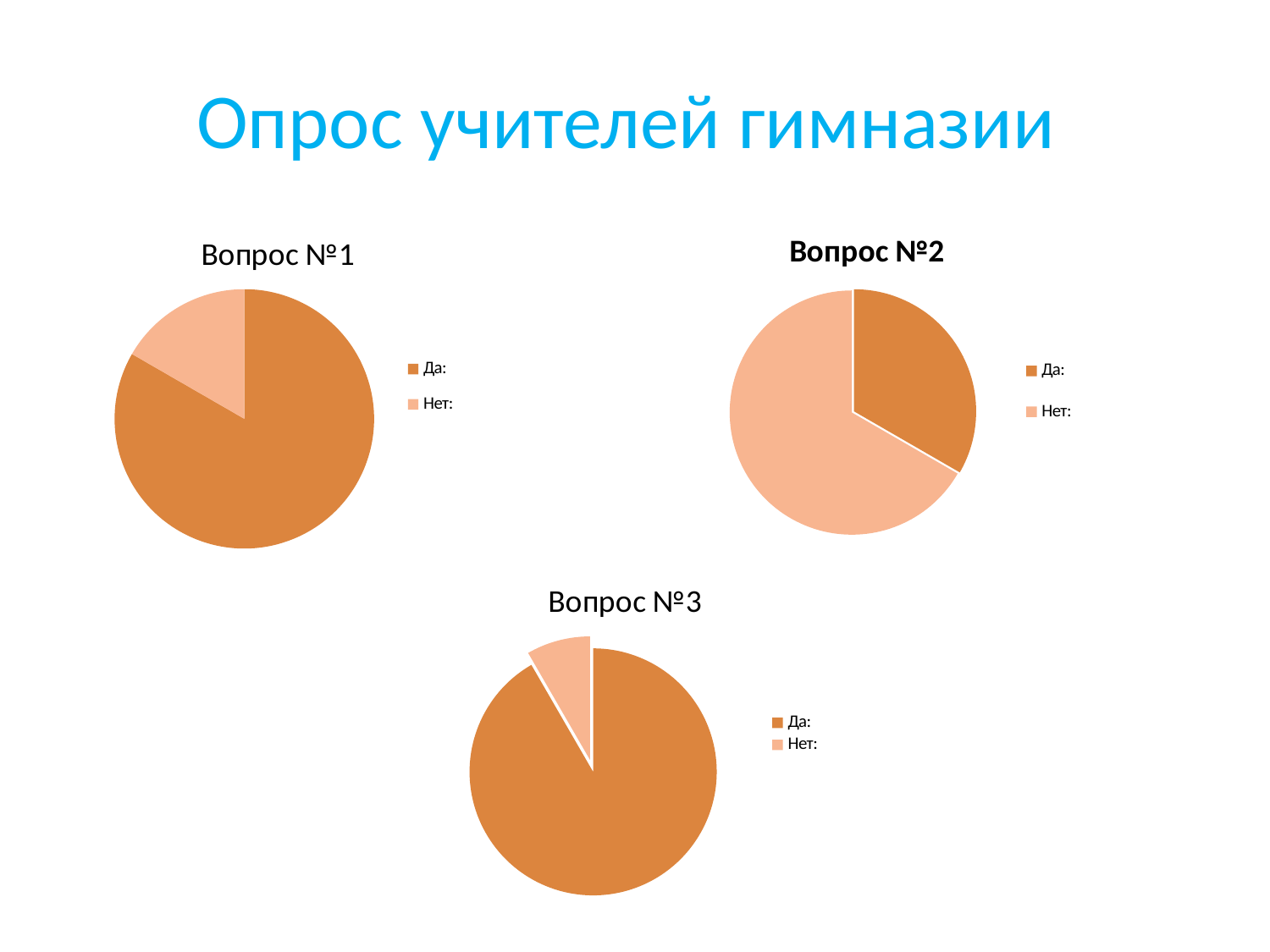
In the chart "Вопрос №3", which slice is the smallest? Нет: What kind of chart is "Вопрос №1"? pie chart How many pie charts are shown on the slide? 3 How many entries does the legend of the chart "Вопрос №3" list? 2 In the chart "Вопрос №1", which slice is larger, "Да:" or "Нет:"? Да: In the chart "Вопрос №2", which slice is the largest? Нет: How many slices does the chart "Вопрос №1" have? 2 In the chart "Вопрос №2", which slice is the smallest? Да: In the chart "Вопрос №3", which slice is larger, "Да:" or "Нет:"? Да: What is the title of the chart at the bottom of the slide? Вопрос №3 In the chart "Вопрос №2", which legend entry is shown in the lighter colour? Нет: